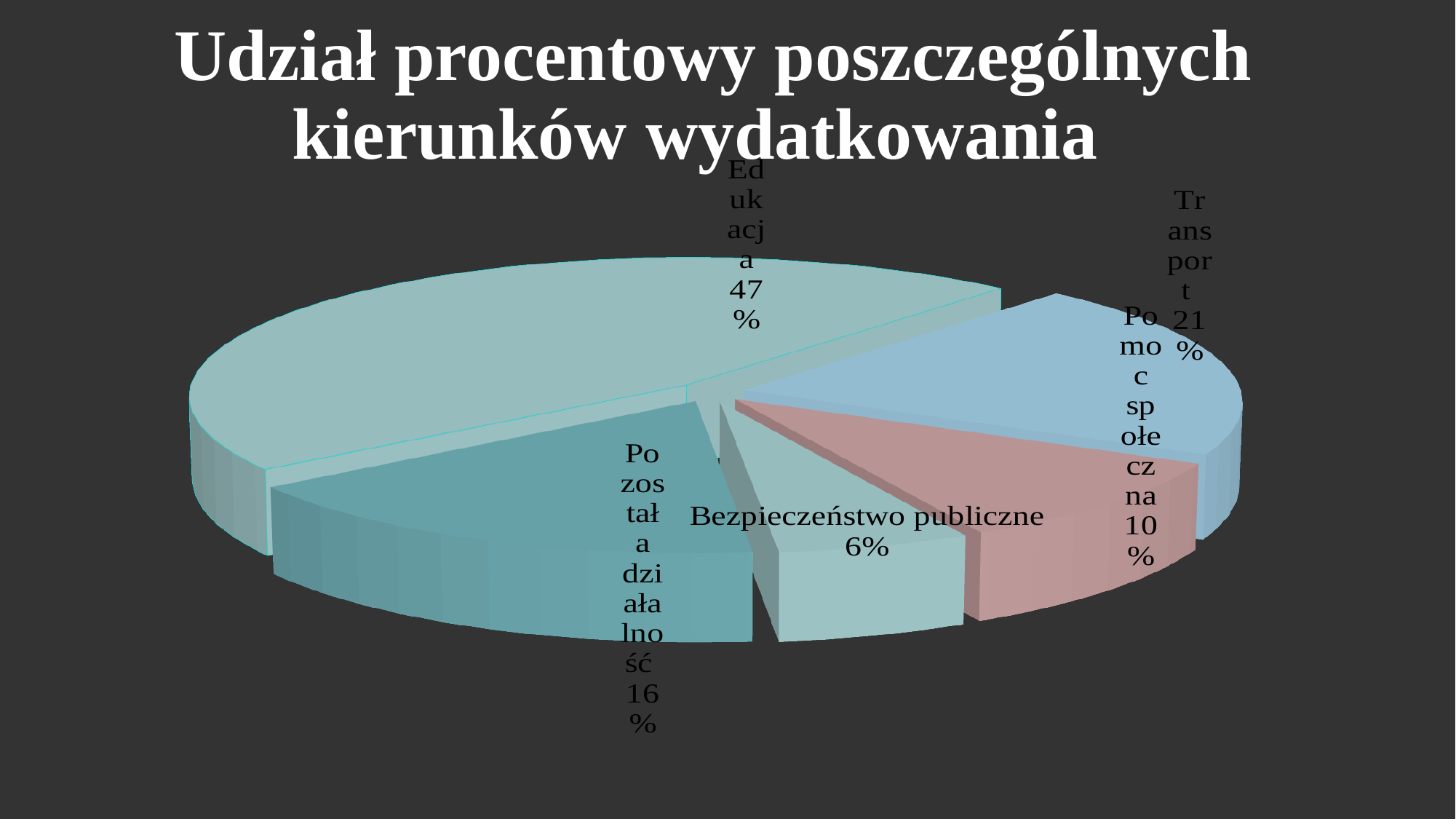
What kind of chart is shown on the slide? Pie chart Which has a larger share, Pozostała działalność or Pomoc społeczna? Pozostała działalność What is the share for Edukacja? 47% What is the share for Bezpieczeństwo publiczne? 6% What is the title of the chart on the slide? Udział procentowy poszczególnych kierunków wydatkowania Which category has the largest share of the pie? Edukacja What is the share for Pomoc społeczna? 10% Which category has the smallest share of the pie? Bezpieczeństwo publiczne What is the difference in percentage points between Edukacja and Transport? 26 What is the share for Pozostała działalność? 16% How many categories are shown in the pie chart? 5 What is the share for Transport? 21%